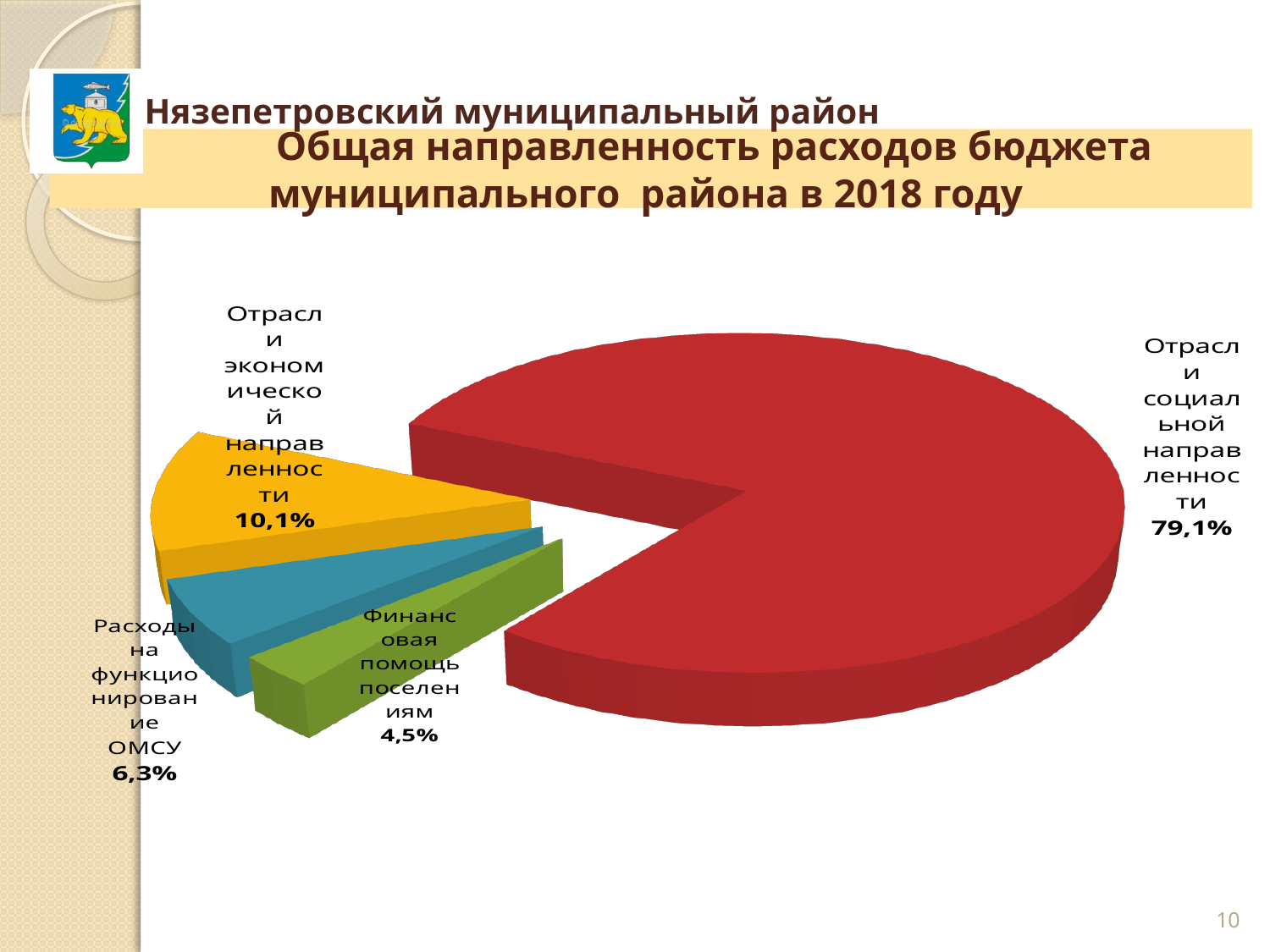
Which category has the smallest share of the pie? Финансовая помощь поселениям Which is larger: the share for Расходы на функционирование ОМСУ or the share for Финансовая помощь поселениям? Расходы на функционирование ОМСУ What share of the budget expenditure goes to Расходы на функционирование ОМСУ? 6,3% How many slices does the pie chart have? 4 What share of the budget expenditure goes to Отрасли экономической направленности? 10,1% What share of the budget expenditure goes to Финансовая помощь поселениям? 4,5% Which category has the largest share of the pie? Отрасли социальной направленности What is the difference in percentage points between Отрасли экономической направленности and Расходы на функционирование ОМСУ? 3,8 What share of the budget expenditure goes to Отрасли социальной направленности? 79,1% What is the title of the chart? Общая направленность расходов бюджета муниципального района в 2018 году What kind of chart is shown on the slide? pie chart What colour is the slice for Отрасли социальной направленности? red